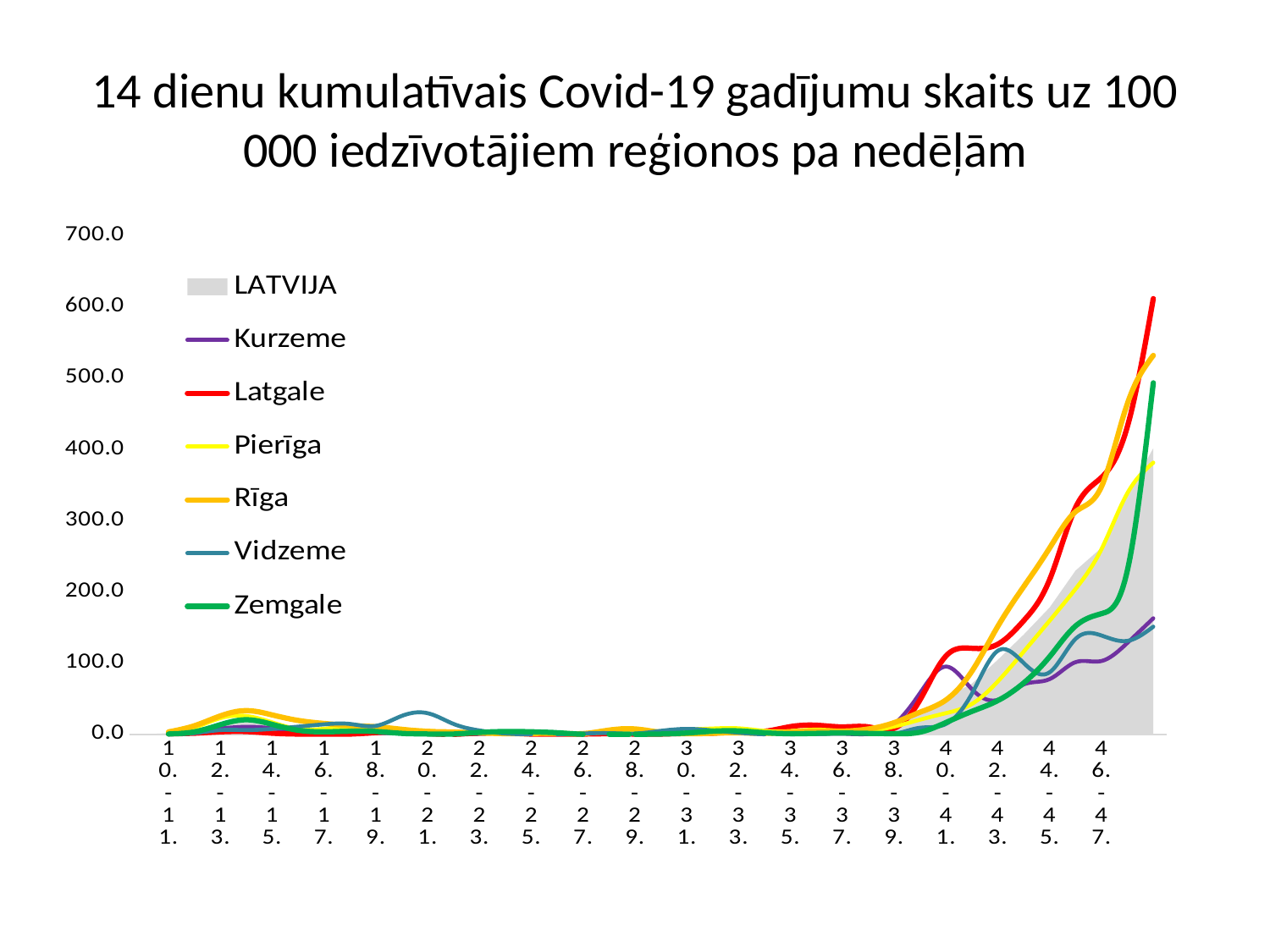
Which region has the highest value at the right end of the chart? Latgale At the right end of the chart, which is larger, Latgale or Kurzeme? Latgale What is the title of the chart? 14 dienu kumulatīvais Covid-19 gadījumu skaits uz 100 000 iedzīvotājiem reģionos pa nedēļām What kind of chart is shown on the slide? combination area and line chart Is the value for Zemgale at the right end of the chart greater or less than 400? greater At the right end of the chart, which is larger, Rīga or Pierīga? Rīga How many series does the legend list? 7 Is the value for Kurzeme at the right end of the chart greater or less than 200? less Is the value for Vidzeme at the right end of the chart greater or less than 300? less Which series is shown as a grey shaded area rather than a line? LATVIJA Do the values for Latgale rise or fall over the last weeks shown on the x axis? rise